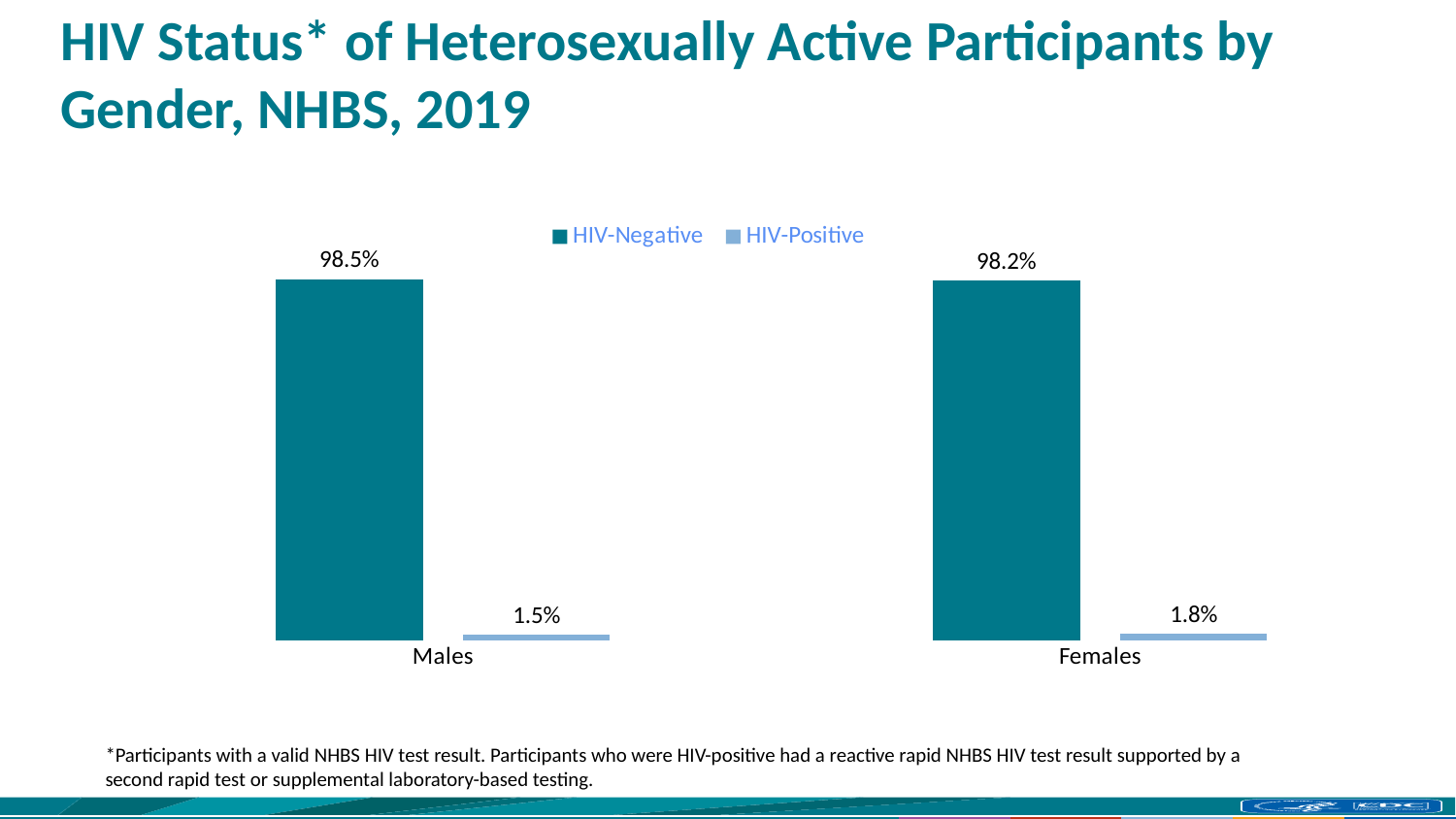
What is the difference between the HIV-Negative percentages for Males and Females? 0.3% How many series does the legend list? 2 What kind of chart is shown on the slide? Bar chart What percentage of male participants were HIV-Negative? 98.5% How many gender categories are shown on the x axis? 2 What percentage of male participants were HIV-Positive? 1.5% Which gender has the higher HIV-Negative percentage? Males Which gender has the higher HIV-Positive percentage? Females What are the two series named in the legend? HIV-Negative and HIV-Positive What is the difference between the HIV-Positive percentages for Females and Males? 0.3% What percentage of female participants were HIV-Negative? 98.2% What percentage of female participants were HIV-Positive? 1.8%